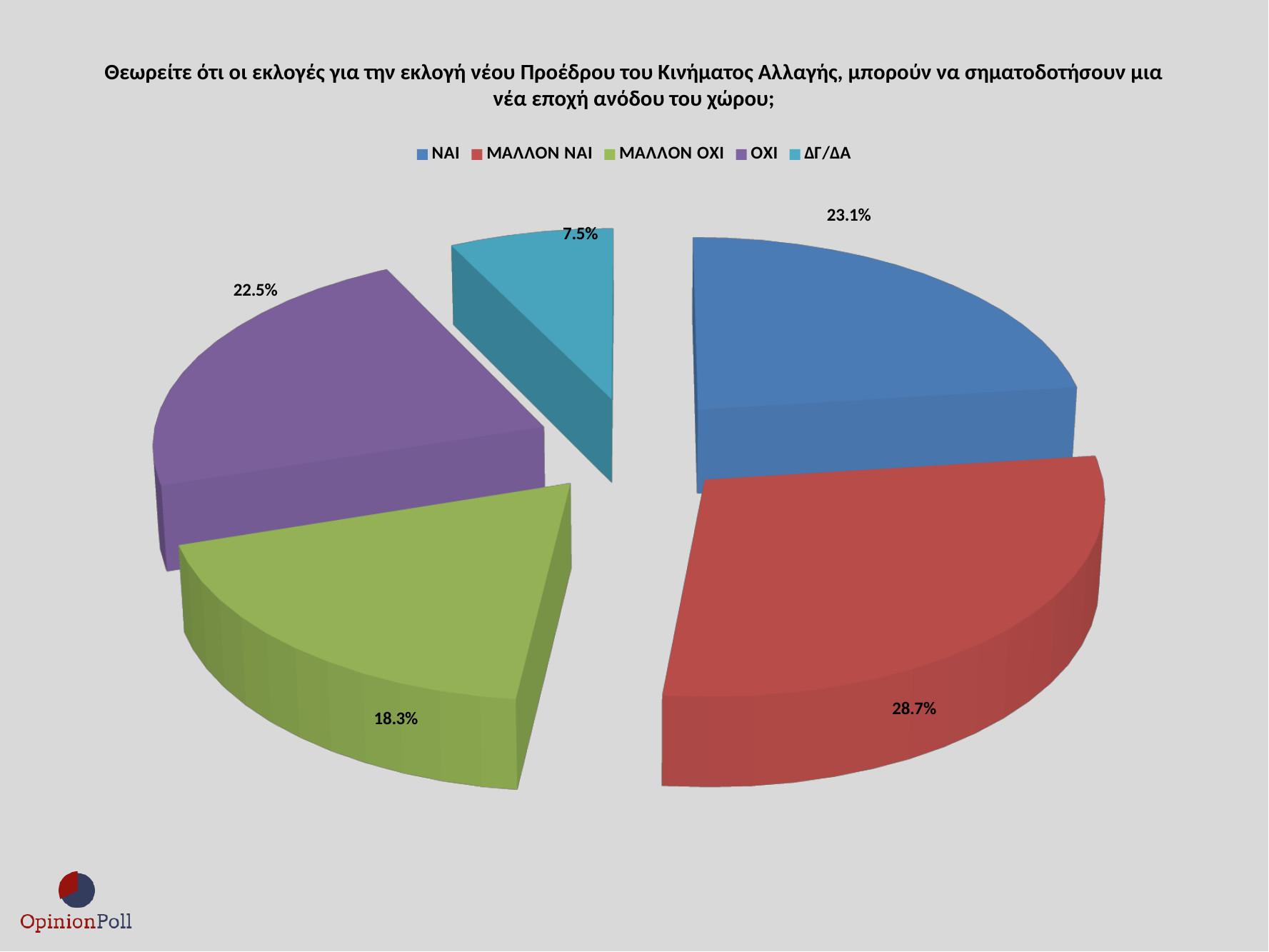
Which response has the largest share of the pie? ΜΑΛΛΟΝ ΝΑΙ What is the difference in percentage points between ΜΑΛΛΟΝ ΝΑΙ and ΝΑΙ? 5.6 What percentage of respondents answered ΜΑΛΛΟΝ ΝΑΙ? 28.7% Which colour represents ΟΧΙ in the legend? Purple What percentage of respondents answered ΟΧΙ? 22.5% Which response has the smallest share of the pie? ΔΓ/ΔΑ What percentage of respondents answered ΝΑΙ? 23.1% How many slices does the pie chart have? 5 What percentage of respondents answered ΔΓ/ΔΑ? 7.5% Which is larger, the share for ΟΧΙ or the share for ΜΑΛΛΟΝ ΟΧΙ? ΟΧΙ What percentage of respondents answered ΜΑΛΛΟΝ ΟΧΙ? 18.3% What kind of chart is shown on the slide? Pie chart